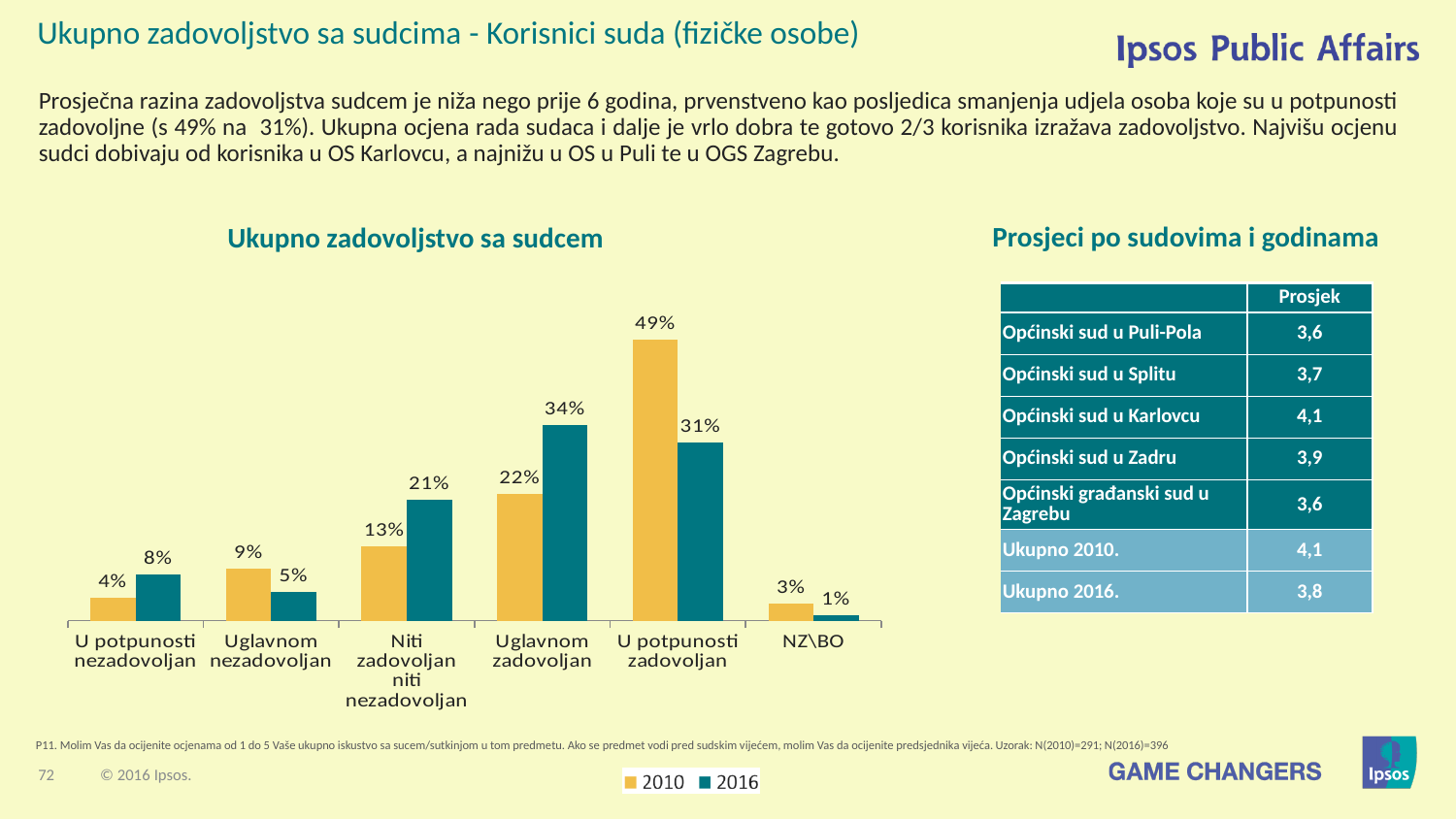
What is the 2016 value for "Uglavnom zadovoljan"? 34% What is the 2010 value for "U potpunosti zadovoljan"? 49% Which category has the highest 2010 value? U potpunosti zadovoljan Which is larger for "Uglavnom nezadovoljan": the 2010 value or the 2016 value? 2010 What is the difference between the 2010 and 2016 values for "U potpunosti zadovoljan"? 18% Which category has the lowest 2016 value? NZ\BO How many categories are shown on the x axis of the chart? 6 How many series does the legend of the chart list? 2 What is the 2016 value for "Niti zadovoljan niti nezadovoljan"? 21% What is the title of the chart? Ukupno zadovoljstvo sa sudcem What kind of chart is shown on the slide? bar chart What is the difference between the 2016 and 2010 values for "U potpunosti nezadovoljan"? 4%